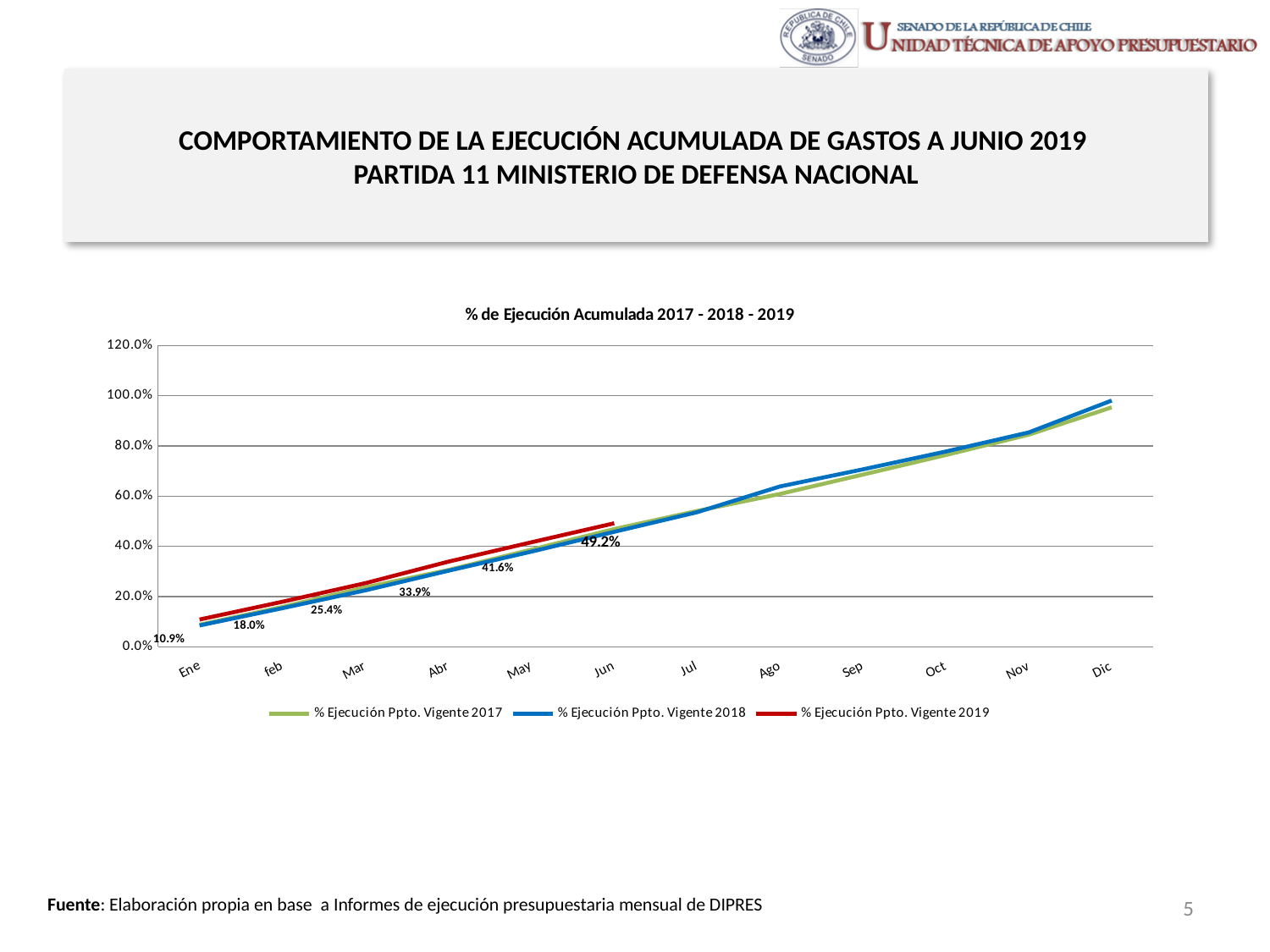
What is the value for % Ejecución Ppto. Vigente 2019 in Mar? 25.4% What is the difference between the 2019 values for Jun and Ene? 38.3% Is the value for % Ejecución Ppto. Vigente 2018 in Dic greater or less than 80.0%? greater What is the value for % Ejecución Ppto. Vigente 2019 in Ene? 10.9% Which month has the highest value for % Ejecución Ppto. Vigente 2019? Jun What is the title of the chart? % de Ejecución Acumulada 2017 - 2018 - 2019 What is the value for % Ejecución Ppto. Vigente 2019 in Jun? 49.2% What type of chart is shown on the slide? line chart How many months are shown on the x axis? 12 What is the difference between the 2019 values for May and Abr? 7.7% How many series does the legend list? 3 Do the values for % Ejecución Ppto. Vigente 2019 rise or fall from Ene to Jun? rise